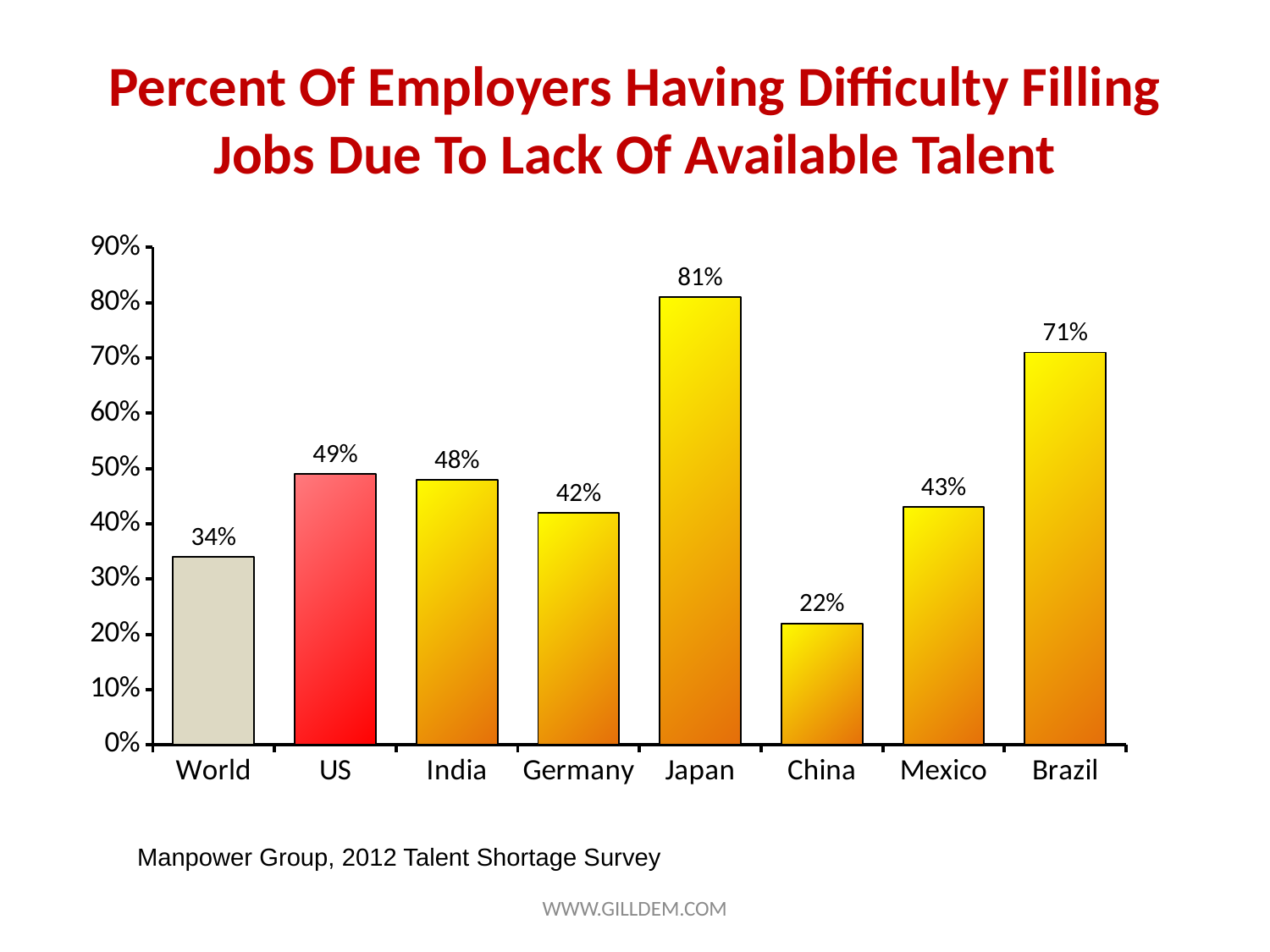
What is the value for China? 22% Which is larger, the value for Germany or the value for Mexico? Mexico What is the value for Japan? 81% How many categories are shown on the x axis? 8 Which category has the lowest value? China Is the value for Brazil greater or less than 60%? greater Which category has the highest value? Japan What is the value for World? 34% What is the value for the US? 49% What is the difference between the values for Japan and Brazil? 10% What kind of chart is shown on the slide? bar chart What is the difference between the values for the US and World? 15%